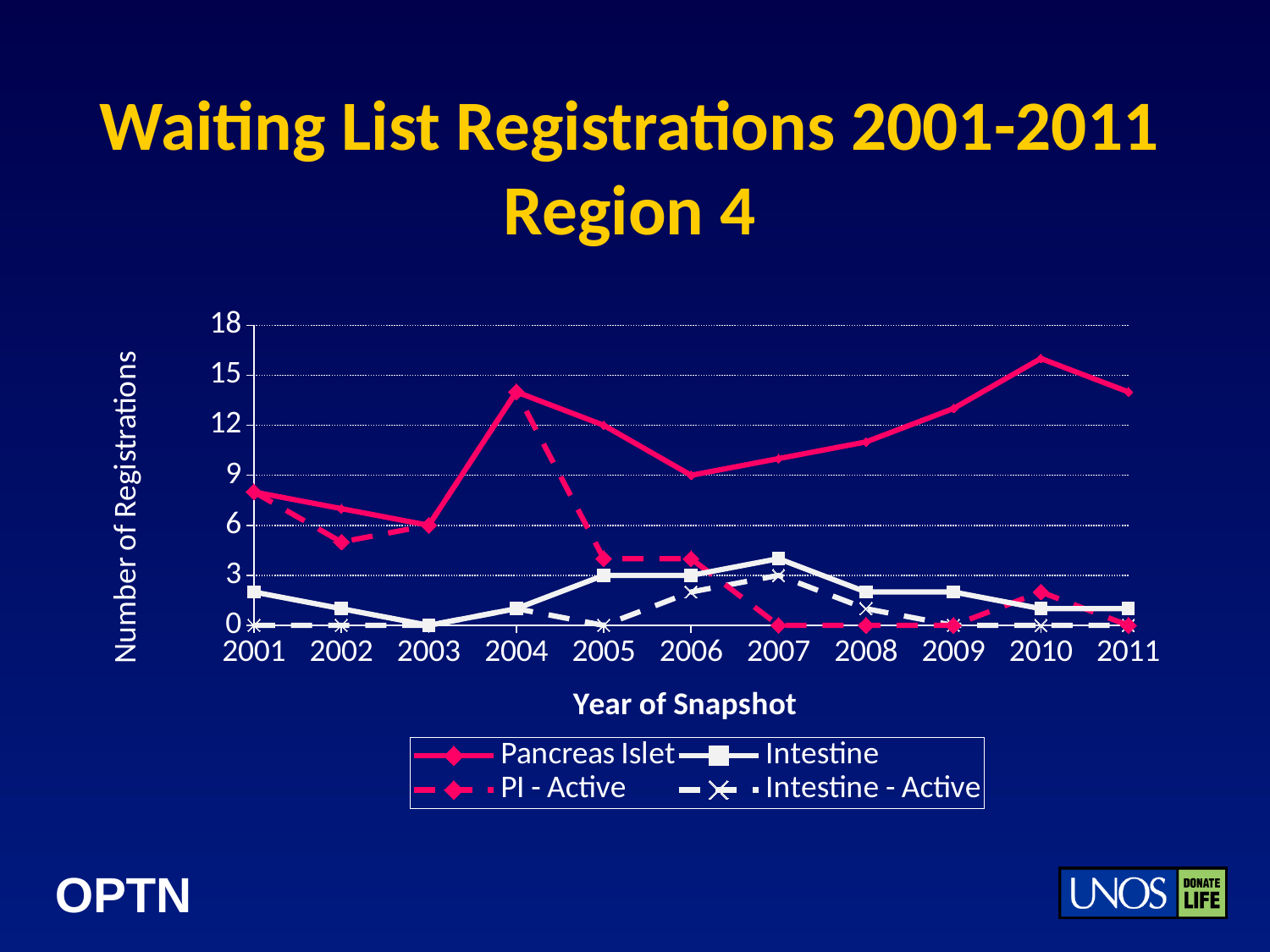
How many series does the legend list? 4 What is the value for PI - Active in 2008? 0 Which series has the higher value in 2009, Pancreas Islet or Intestine? Pancreas Islet In which year does the Pancreas Islet series reach its highest value? 2010 What is the value for Pancreas Islet in 2006? 9 Is the value for Pancreas Islet in 2010 greater or less than 15? greater What is the value for Pancreas Islet in 2005? 12 Does the Pancreas Islet series rise or fall from 2006 to 2010? rise What kind of chart is shown on the slide? line chart How many years are plotted along the x axis? 11 In which year does the Pancreas Islet series have its lowest value? 2003 What is the value for Intestine - Active in 2007? 3